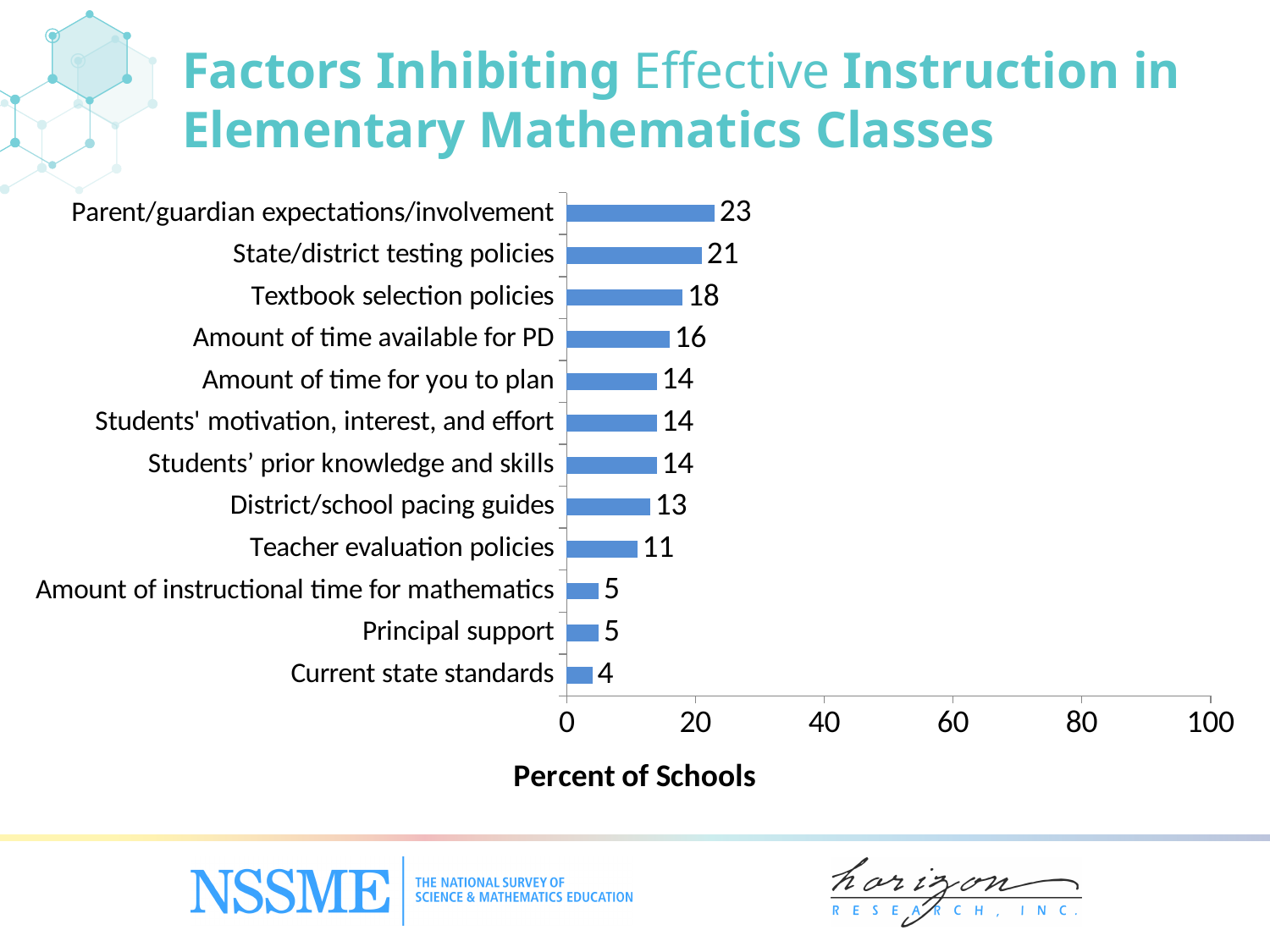
What is the value for Textbook selection policies? 18 What percent of schools reported Parent/guardian expectations/involvement as a factor inhibiting effective instruction? 23 Which factor has the lowest percent of schools? Current state standards How many factors (categories) are shown in the chart? 12 Which is larger: the value for Amount of time available for PD or the value for Amount of time for you to plan? Amount of time available for PD Which factor has the highest percent of schools? Parent/guardian expectations/involvement What kind of chart is shown on the slide? bar chart What is the value for Principal support? 5 Is the value for Parent/guardian expectations/involvement greater or less than 20? greater What is the label of the horizontal axis? Percent of Schools What is the value for Teacher evaluation policies? 11 What is the difference between the values for State/district testing policies and District/school pacing guides? 8